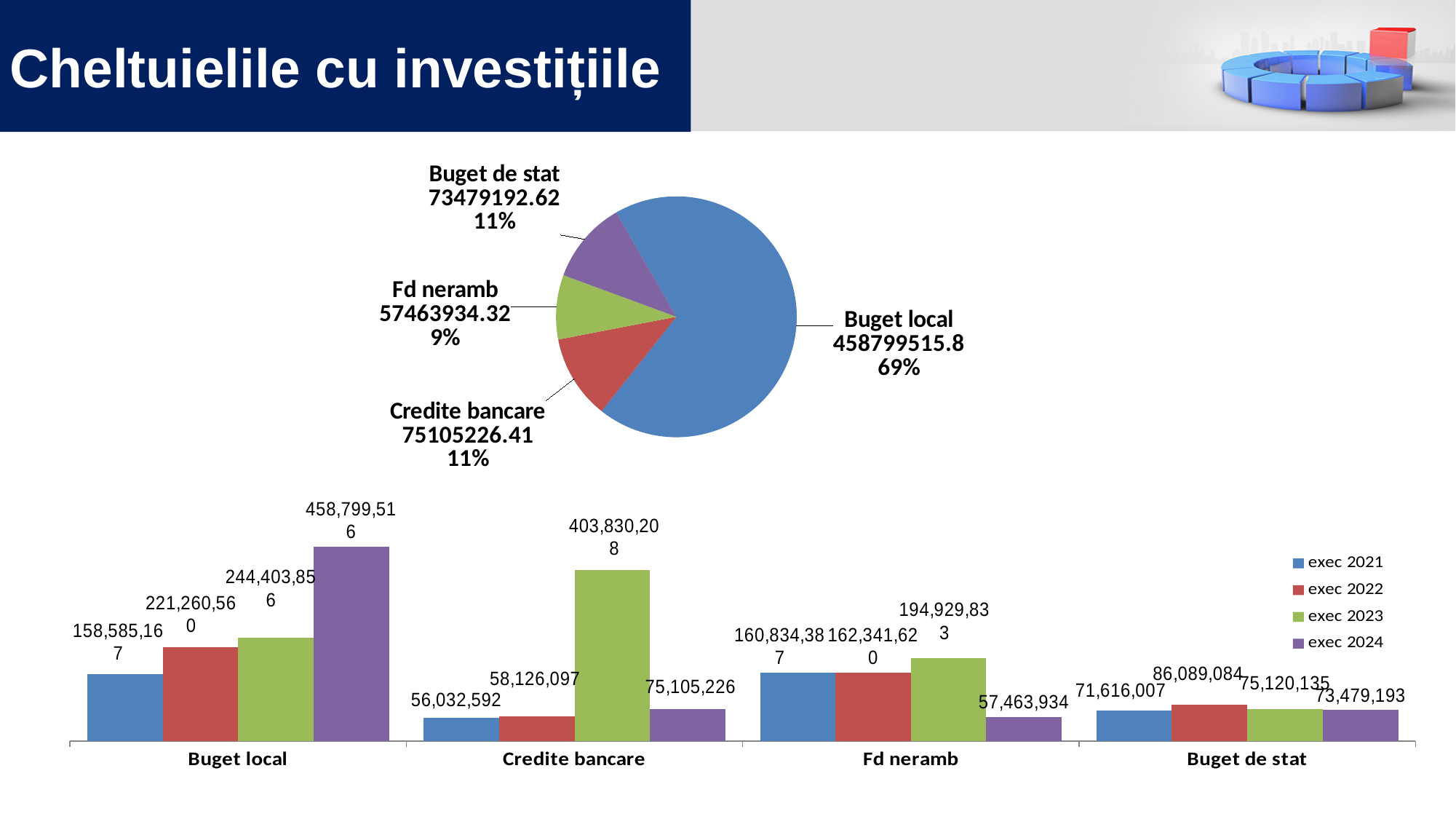
What type of chart is the bottom chart on the slide? bar chart In the bar chart, what is the difference between exec 2024 and exec 2023 for Buget local? 214,395,660 In the bar chart, what is the value for exec 2023 in Credite bancare? 403,830,208 In the bar chart, which is larger for Buget de stat: exec 2022 or exec 2021? exec 2022 In the bar chart, which series has the lowest value for Credite bancare? exec 2021 How many series does the bar chart's legend list? 4 In the pie chart, what is the value shown for Fd neramb? 57463934.32 In the bar chart, what is the value for exec 2024 in Fd neramb? 57,463,934 How many slices does the pie chart have? 4 In the bar chart, which series has the highest value for Buget local? exec 2024 In the pie chart, which slice is the smallest? Fd neramb In the pie chart, what share does Buget local have? 69%